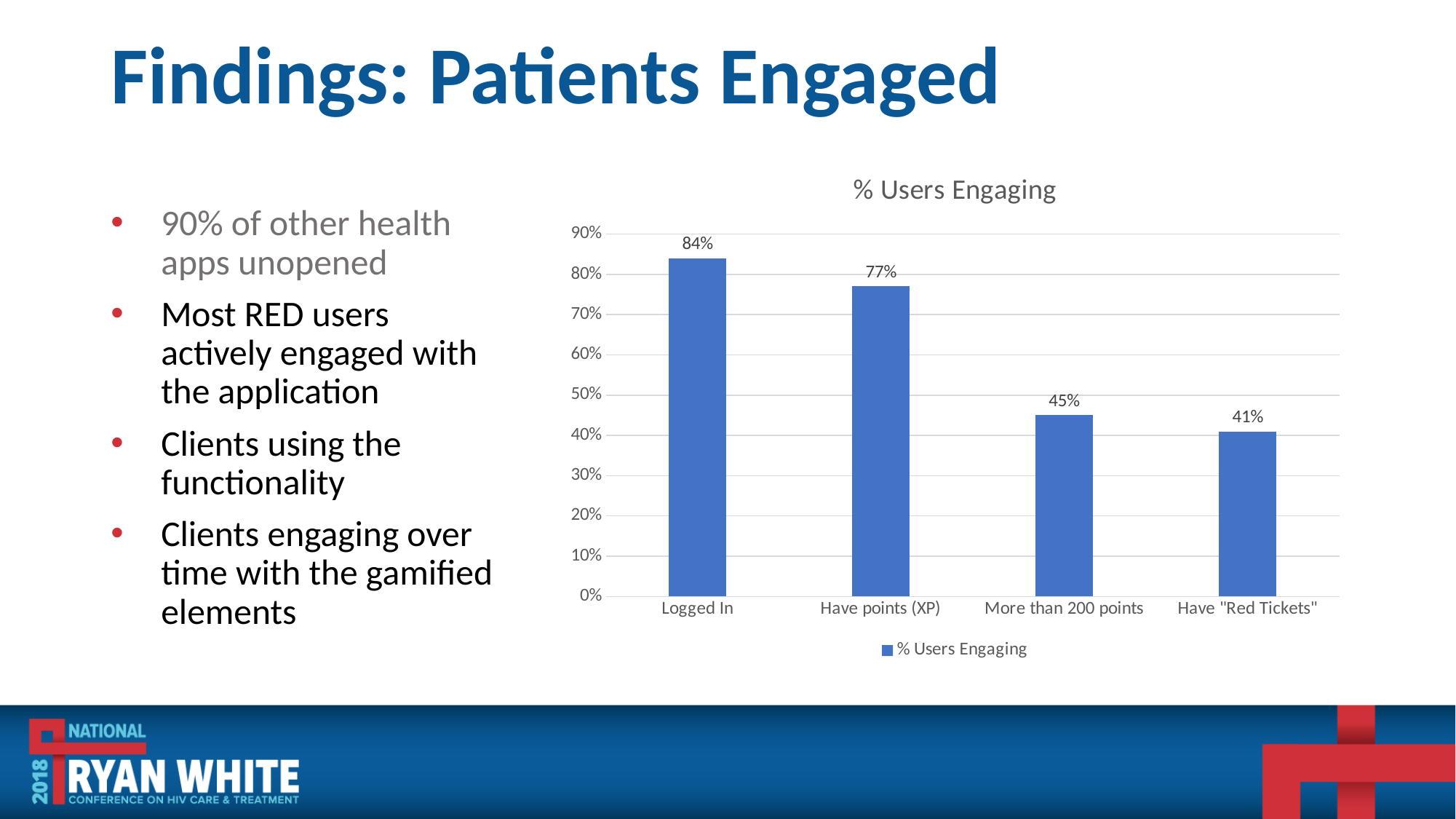
Which category has the highest value? Logged In Which category has the lowest value? Have "Red Tickets" What kind of chart is shown on the slide? bar chart What is the value for Have "Red Tickets"? 41% Is the value for Have points (XP) greater or less than 70%? greater What is the value for More than 200 points? 45% How many categories are shown on the x axis? 4 What is the difference between the values for Logged In and Have points (XP)? 7% What is the value for Have points (XP)? 77% What is the title of the chart? % Users Engaging What is the value for Logged In? 84% Which is larger, the value for More than 200 points or the value for Have "Red Tickets"? More than 200 points